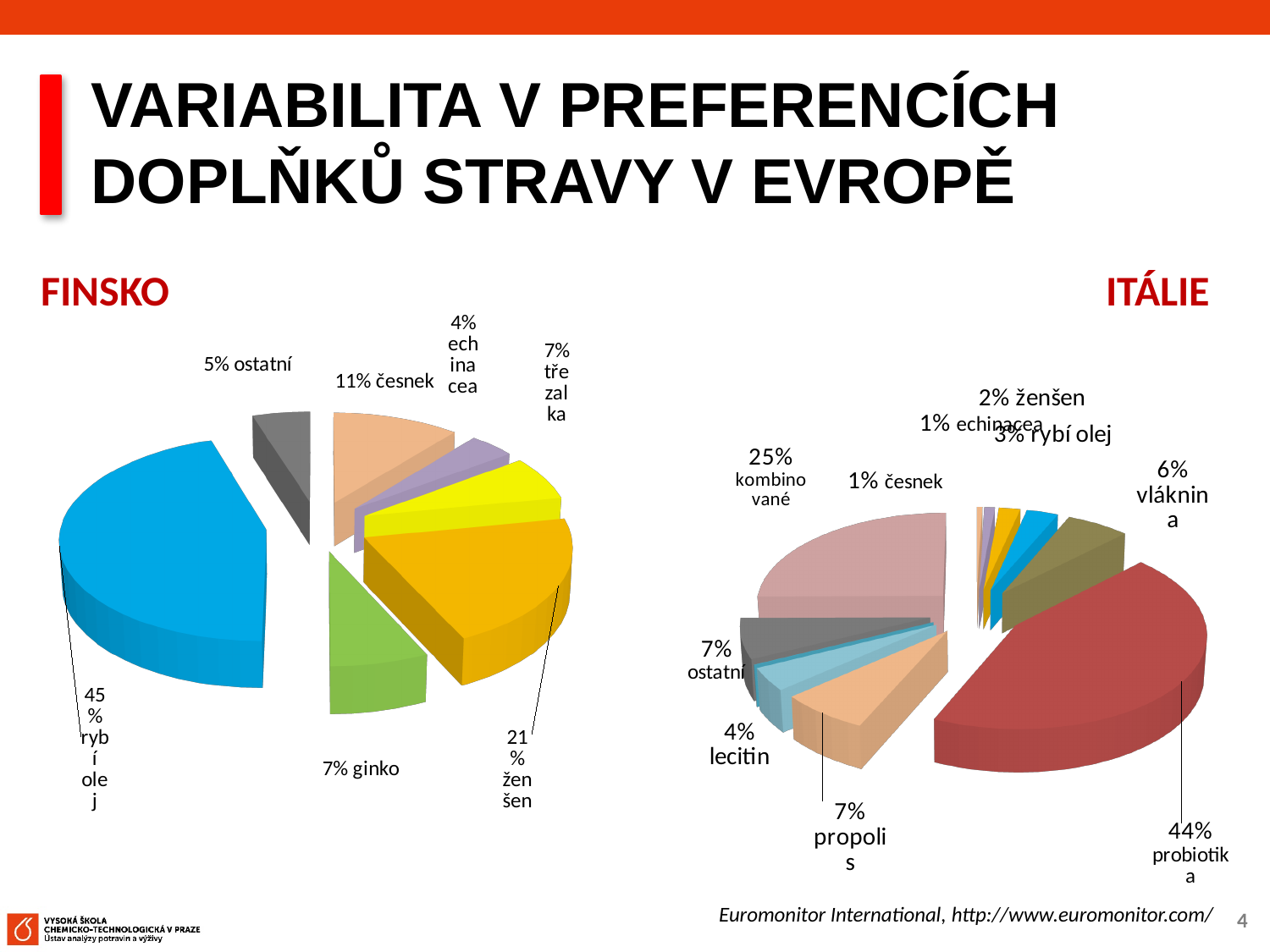
In the FINSKO chart, which category has the smallest share? echinacea In the FINSKO chart, what share is rybí olej? 45% What type of chart is the FINSKO chart? pie chart In the ITÁLIE chart, what share is probiotika? 44% In the ITÁLIE chart, what share is kombinované? 25% In the ITÁLIE chart, which is larger, the share of vláknina or the share of lecitin? vláknina How many categories does the ITÁLIE chart show? 10 In the FINSKO chart, what is the difference between the shares of rybí olej and ženšen? 24% In the FINSKO chart, what share is česnek? 11% In the FINSKO chart, which category has the largest share? rybí olej In the ITÁLIE chart, which category has the largest share? probiotika In the FINSKO chart, what share is ženšen? 21%